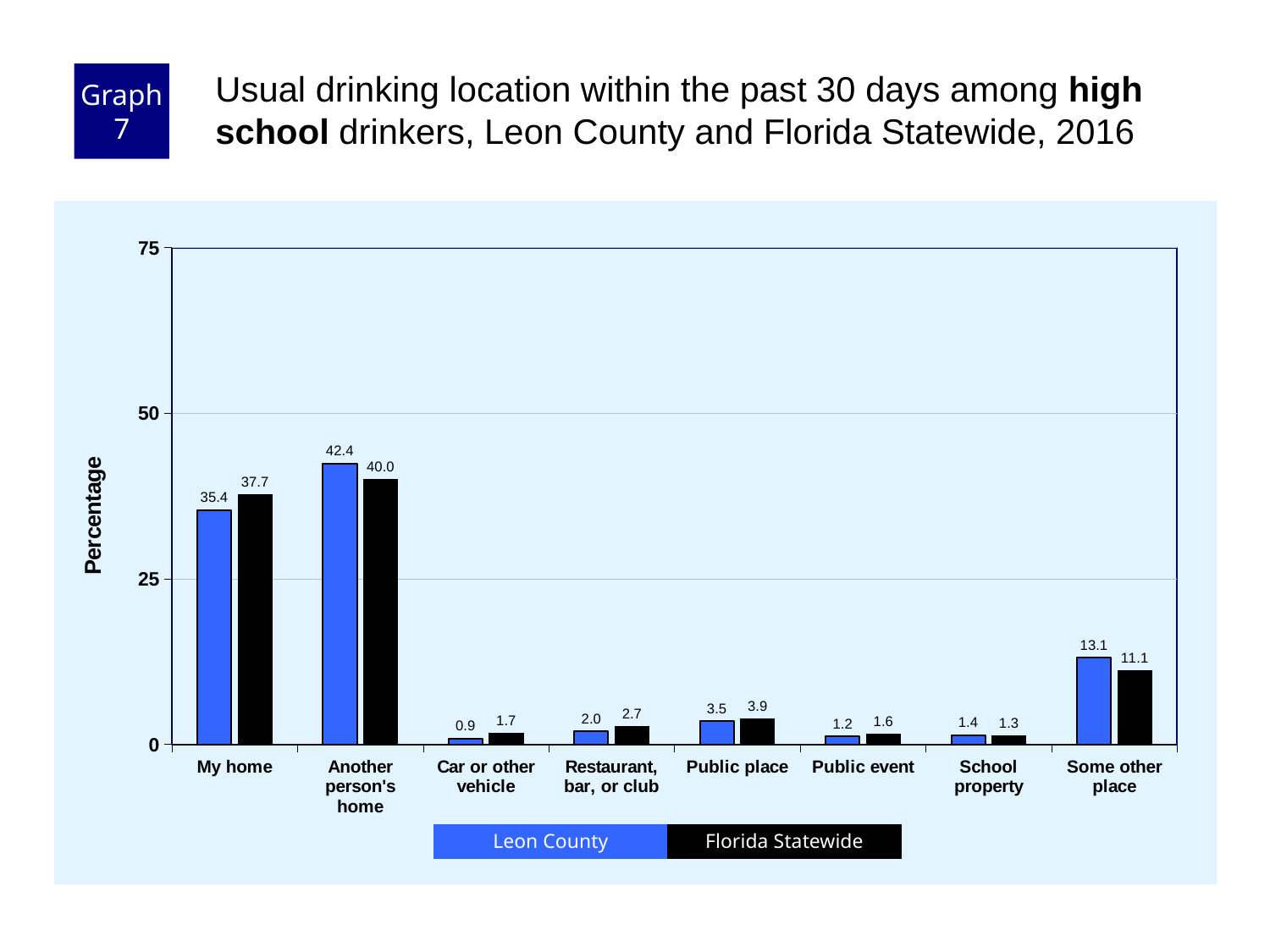
How many drinking location categories are shown on the x axis? 8 What is the Leon County value for "Some other place"? 13.1 What is the Florida Statewide value for "My home"? 37.7 What colour are the Florida Statewide bars? Black What is the difference between the Leon County and Florida Statewide values for "Another person's home"? 2.4 Which category has the highest Florida Statewide value? Another person's home Which is larger for "Some other place": Leon County or Florida Statewide? Leon County How many series does the legend list? 2 What is the Leon County value for "Another person's home"? 42.4 Which category has the lowest Leon County value? Car or other vehicle Is the Leon County value for "My home" greater or less than 25? greater What kind of chart is shown on the slide? Bar chart